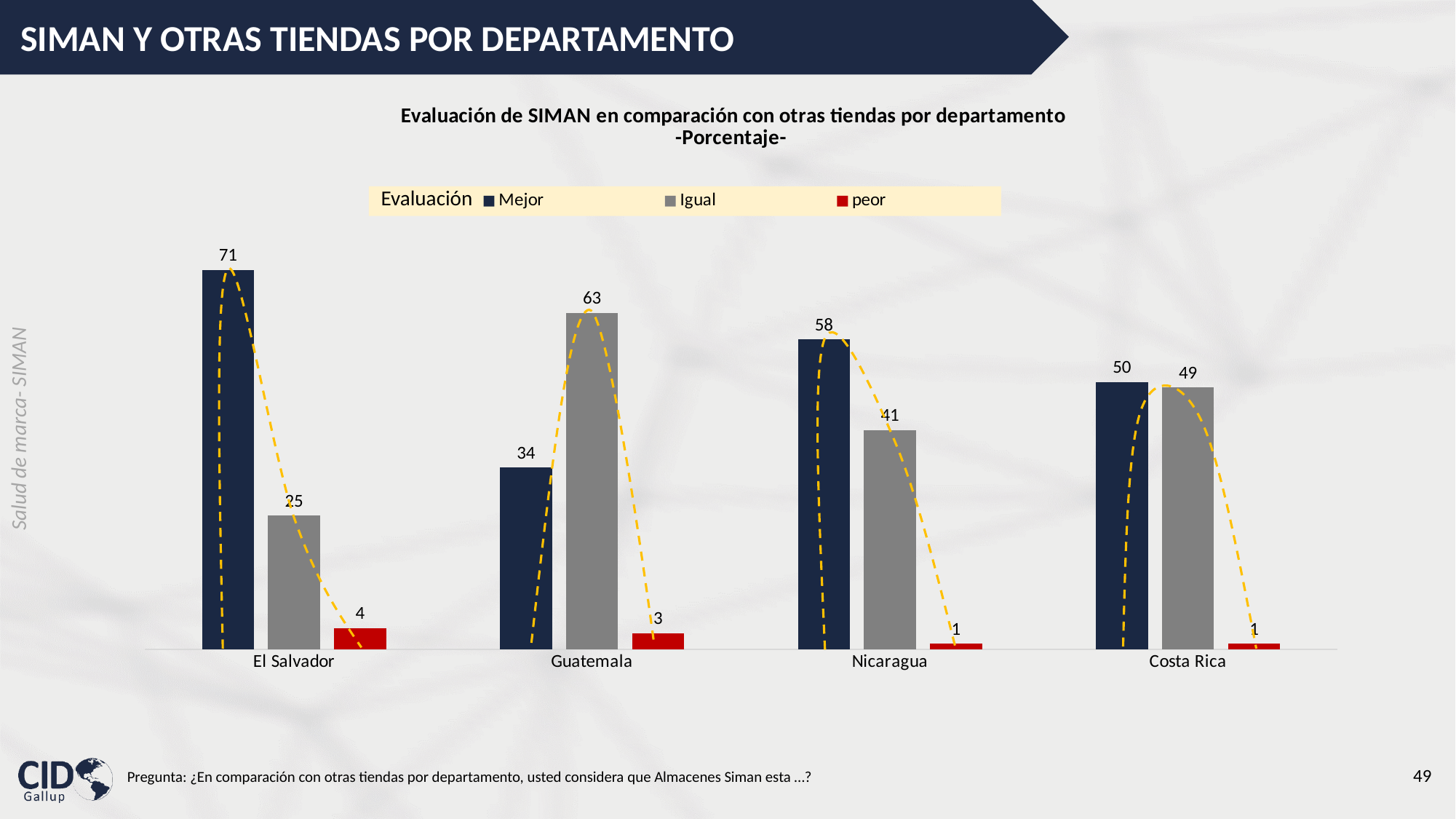
How many countries are shown on the x axis? 4 Which country has the highest value for Mejor? El Salvador What is the value for peor in Nicaragua? 1 What colour are the bars for the peor series? Red What is the value for Igual in Guatemala? 63 Which country has the lowest value for Igual? El Salvador What is the value for Mejor in El Salvador? 71 What is the difference between Mejor and Igual in Nicaragua? 17 Which is larger in Guatemala, Mejor or Igual? Igual How many series does the legend list? 3 What kind of chart is shown on the slide? Bar chart What is the value for Igual in Costa Rica? 49